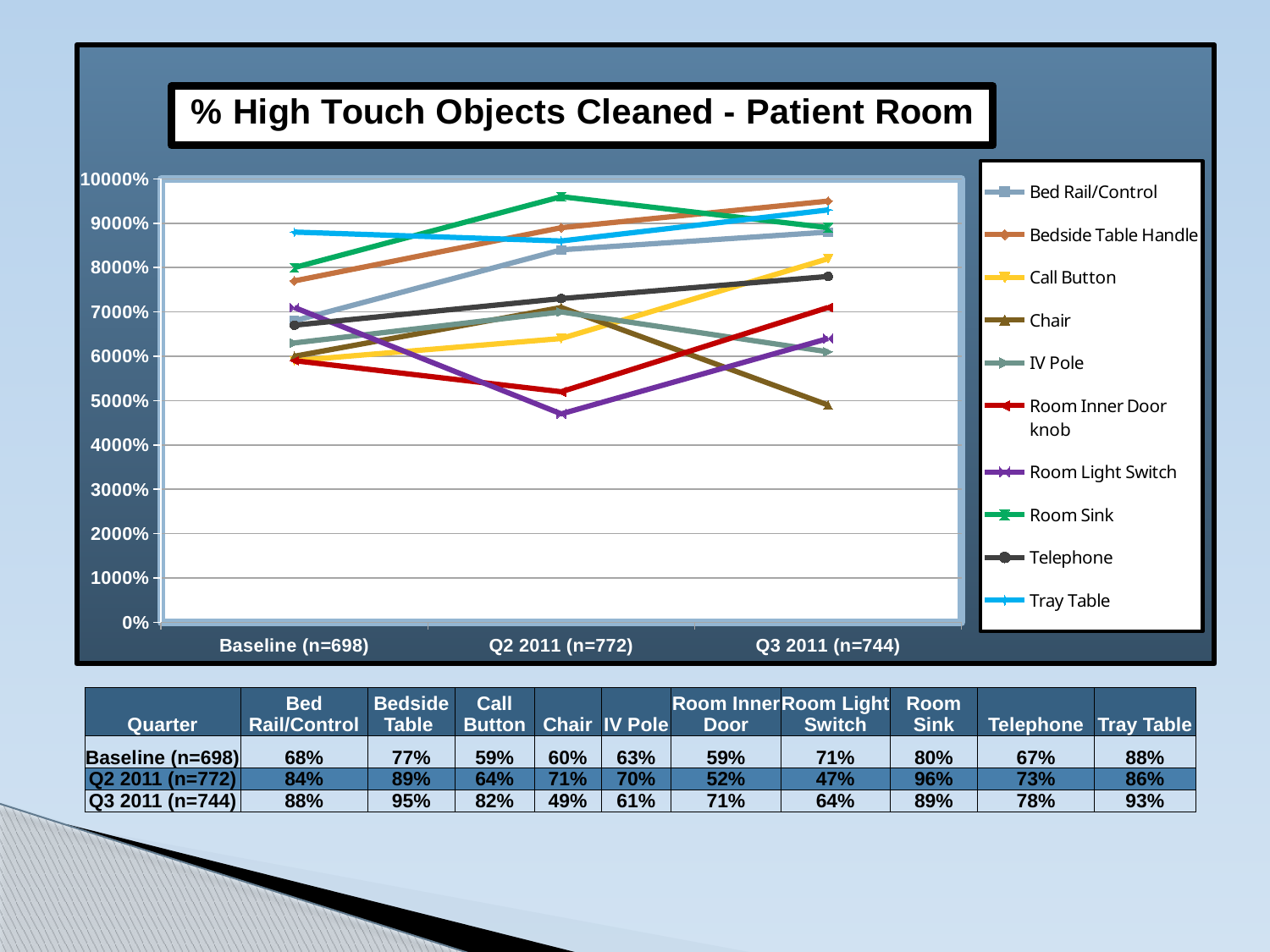
Which object has the lowest value in Q3 2011 (n=744)? Chair How many series does the legend list? 10 By how many percentage points did Bed Rail/Control change from Baseline (n=698) to Q3 2011 (n=744)? 20 percentage points What is the value for Room Sink in Q2 2011 (n=772)? 96% What is the value for Tray Table in Q3 2011 (n=744)? 93% What is the value for Room Light Switch at Baseline (n=698)? 71% Does the Bedside Table Handle value rise or fall from Baseline to Q3 2011? Rise What is the title of the chart? % High Touch Objects Cleaned - Patient Room What kind of chart is shown? Line chart Which object has the highest value in Q2 2011 (n=772)? Room Sink How many quarters are shown on the x axis? 3 In Q3 2011 (n=744), which is larger: Bedside Table or Telephone? Bedside Table